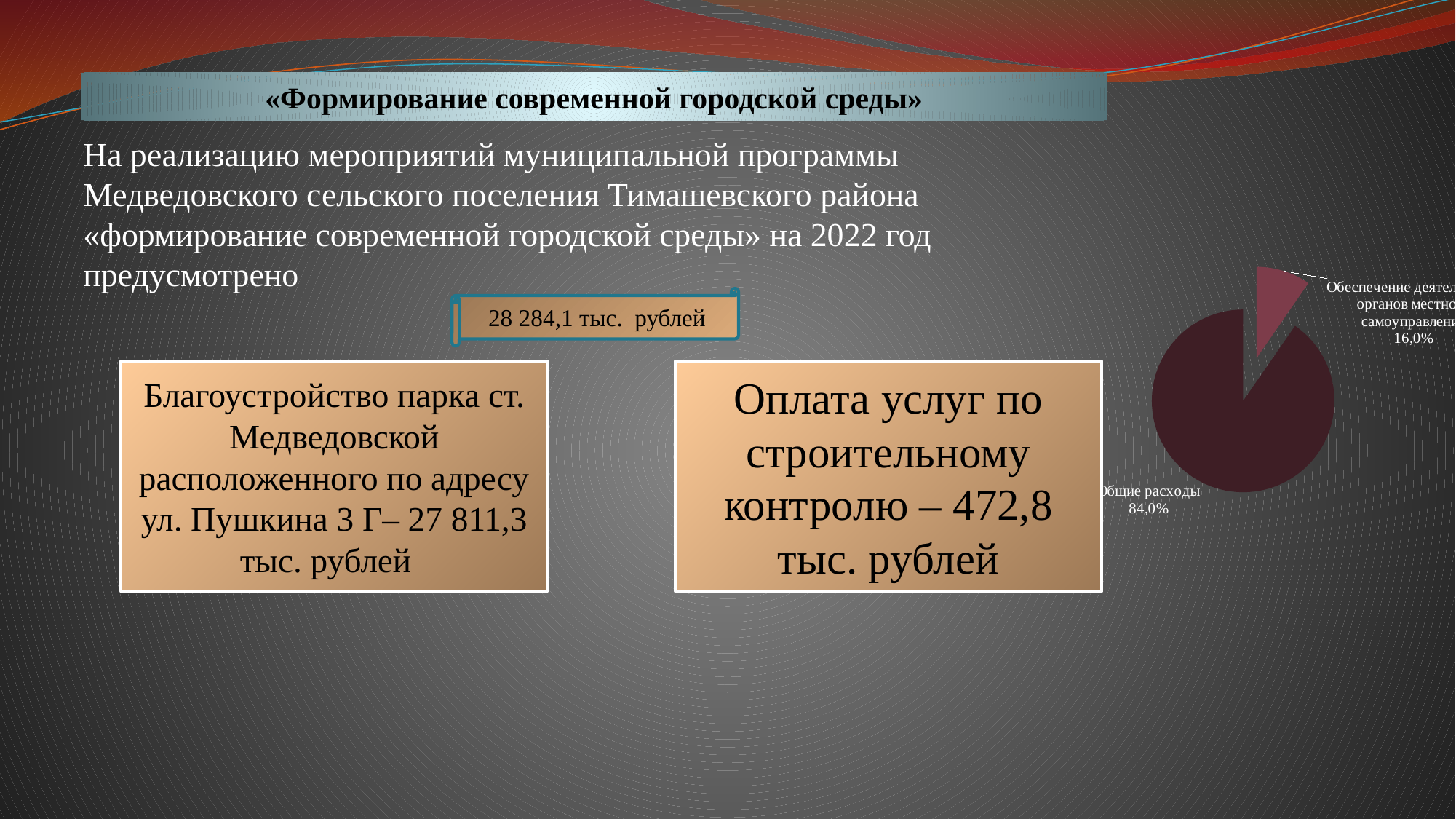
In the pie chart, what share is shown for Общие расходы? 84,0% How many slices does the pie chart have? 2 Which slice of the pie chart is the largest? Общие расходы What kind of chart is shown on the right side of the slide? pie chart What colour is the Общие расходы slice in the pie chart? dark brown In the pie chart, what share is shown for the smaller slice (the one other than Общие расходы)? 16,0% In the pie chart, what is the difference between the share for Общие расходы and the share for the smaller slice? 68,0% In the pie chart, which is larger: the Общие расходы slice or the other slice? Общие расходы